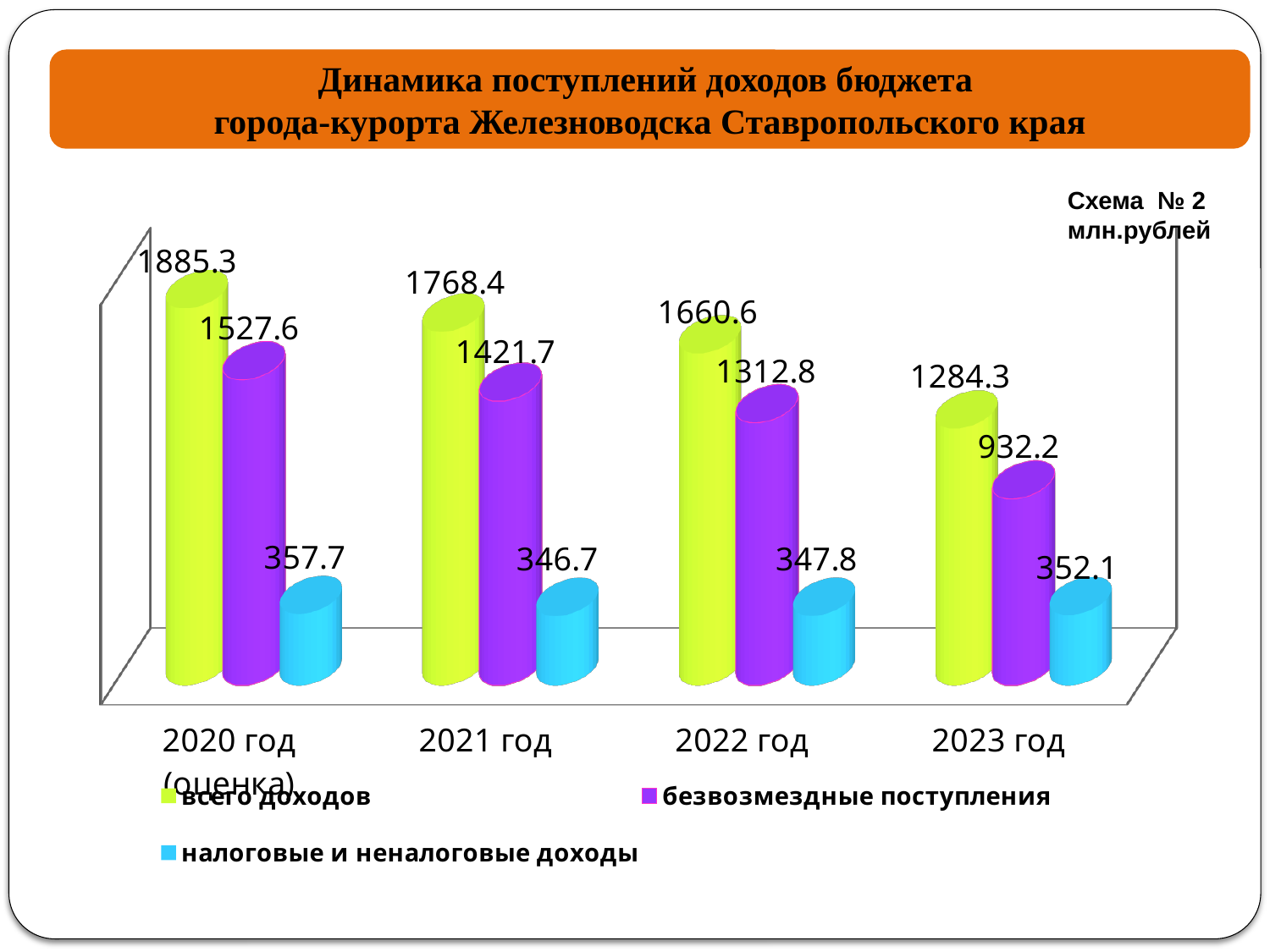
What is the difference between безвозмездные поступления and налоговые и неналоговые доходы in 2021 год? 1075.0 How many series does the legend list? 3 What is the value of налоговые и неналоговые доходы for 2023 год? 352.1 How many years are shown on the x axis? 4 Does всего доходов rise or fall from 2020 год (оценка) to 2023 год? fall What is the value of всего доходов for 2020 год (оценка)? 1885.3 What is the difference between всего доходов in 2020 год (оценка) and in 2023 год? 601.0 What is the value of безвозмездные поступления for 2022 год? 1312.8 In which year is налоговые и неналоговые доходы the highest? 2020 год (оценка) What kind of chart is shown on the slide? bar chart In which year is всего доходов the lowest? 2023 год Which is larger: безвозмездные поступления in 2021 год or in 2022 год? 2021 год